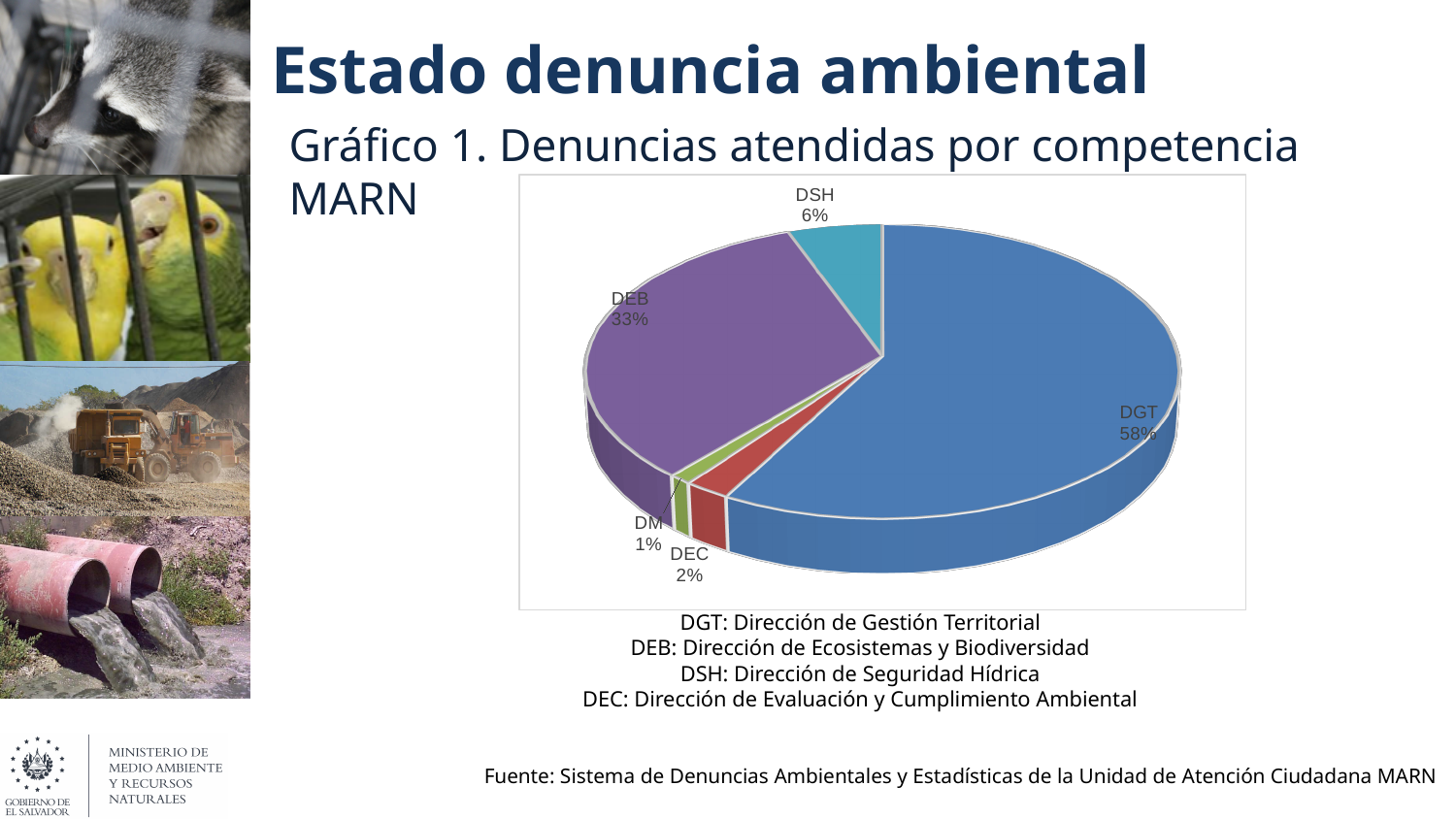
What percentage is shown for DEB? 33% What percentage is shown for DEC? 2% What percentage is shown for DM? 1% What is the title of the chart on the slide? Gráfico 1. Denuncias atendidas por competencia MARN Which category has the largest slice of the pie? DGT What type of chart is shown on the slide? Pie chart What is the difference in percentage points between DGT and DEB? 25 Which is larger, the share for DSH or the share for DEC? DSH What percentage is shown for DSH? 6% How many slices does the pie chart have? 5 What share of the pie does DGT represent? 58% Which category has the smallest slice of the pie? DM